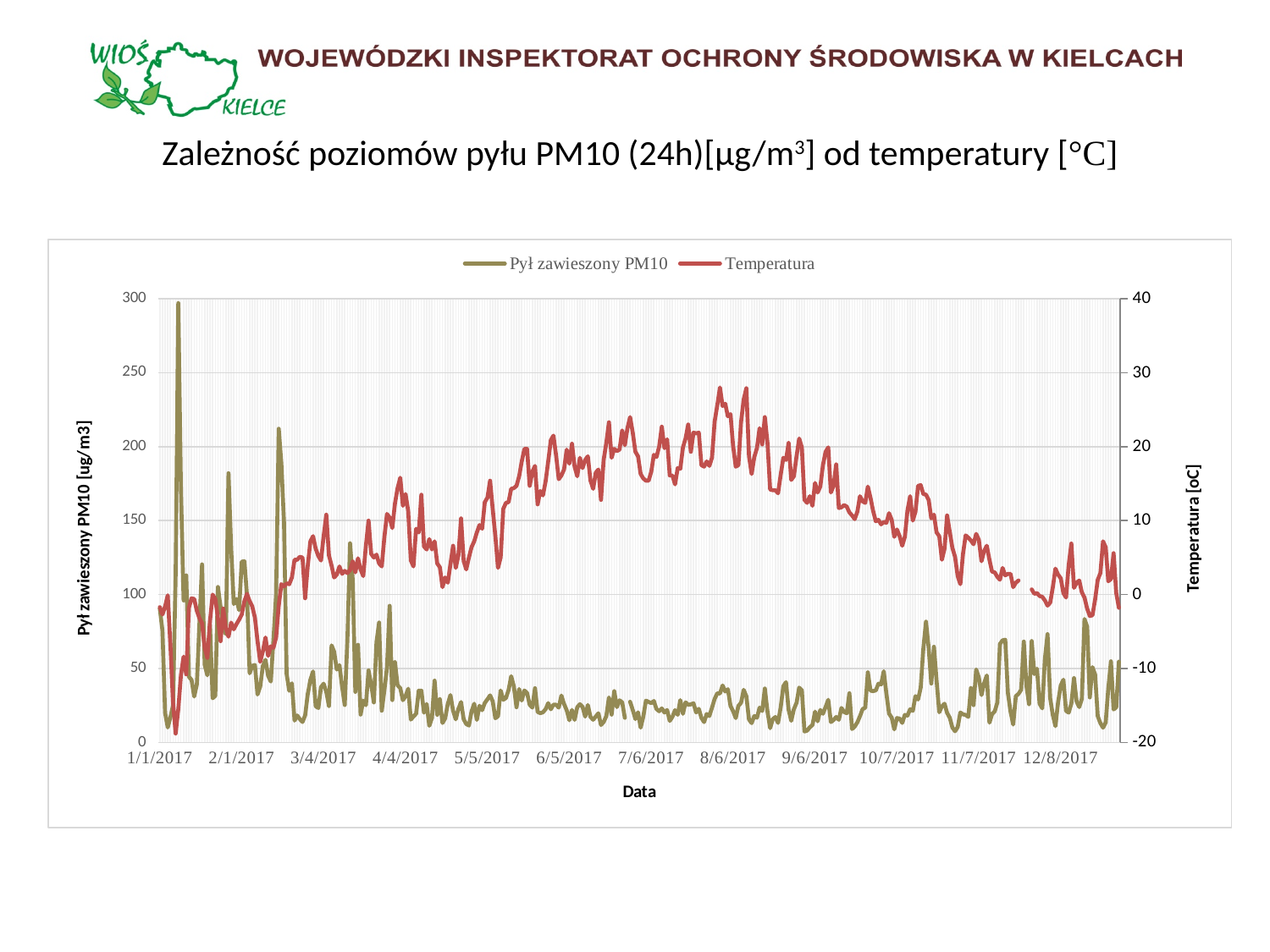
Which series is drawn in red? Temperatura How many series does the chart legend list? 2 What kind of chart is shown on the slide? line chart Is the lowest temperature value in January 2017 greater or less than -10? less Are the PM10 values in July 2017 greater or less than 50? less Is the PM10 value at the start of June 2017 greater or less than 100? less Does the temperature series generally rise or fall from January to August 2017? rise Which is higher: the PM10 peak in January 2017 or the PM10 peak in late February 2017? the January 2017 peak Does the temperature series generally rise or fall from August to December 2017? fall What are the two series named in the chart legend? Pył zawieszony PM10 and Temperatura